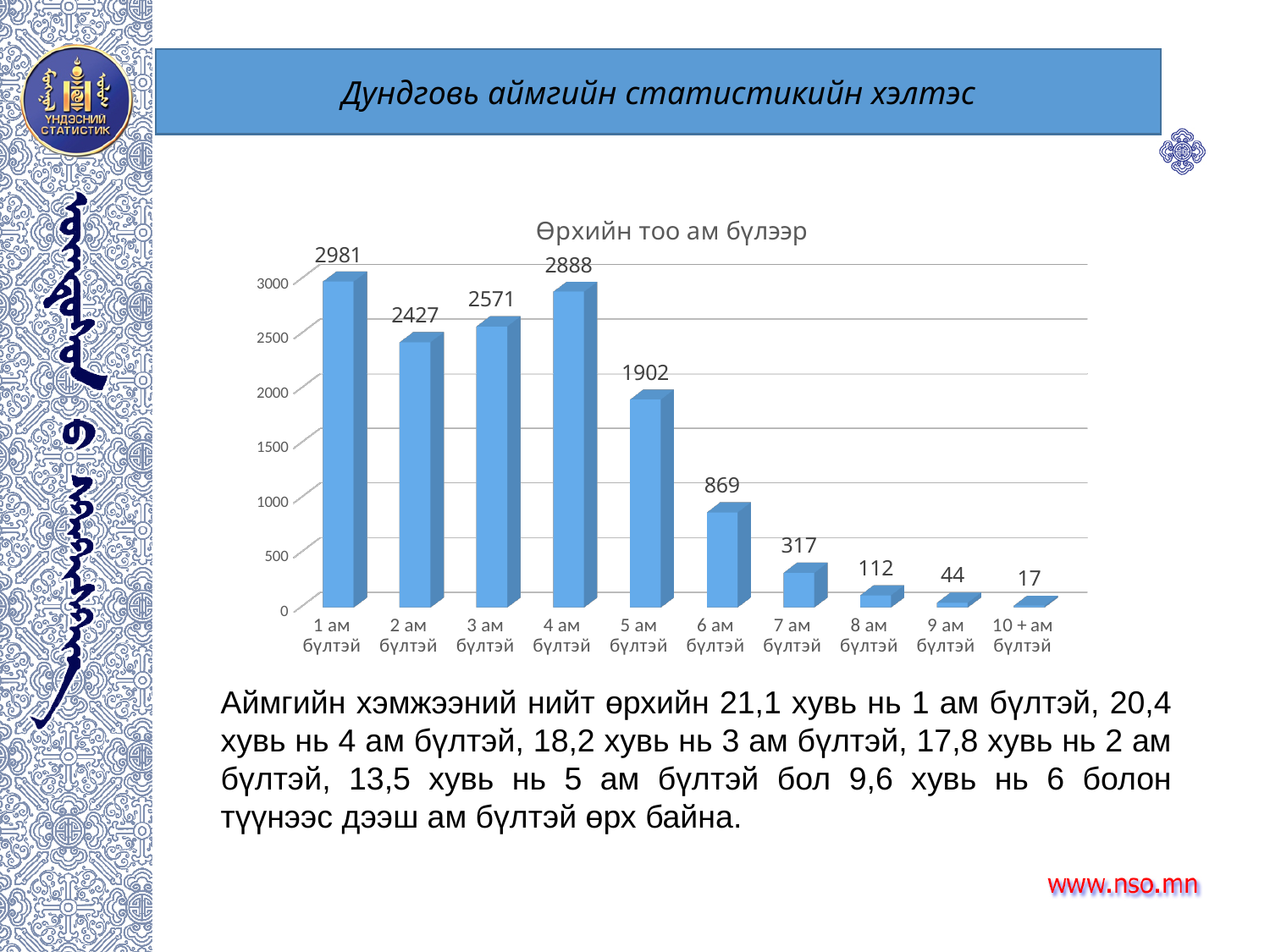
What kind of chart is shown? bar chart What is the difference between the values for 6 ам бүлтэй and 7 ам бүлтэй? 552 Is the value for 6 ам бүлтэй greater or less than 1000? less What is the value for 10 + ам бүлтэй? 17 Which is larger, the value for 2 ам бүлтэй or 3 ам бүлтэй? 3 ам бүлтэй What is the value for 5 ам бүлтэй? 1902 What is the difference between the values for 1 ам бүлтэй and 4 ам бүлтэй? 93 What is the value for 1 ам бүлтэй? 2981 What is the title of the chart? Өрхийн тоо ам бүлээр How many categories are shown on the x axis? 10 Which category has the lowest value? 10 + ам бүлтэй Which category has the highest value? 1 ам бүлтэй